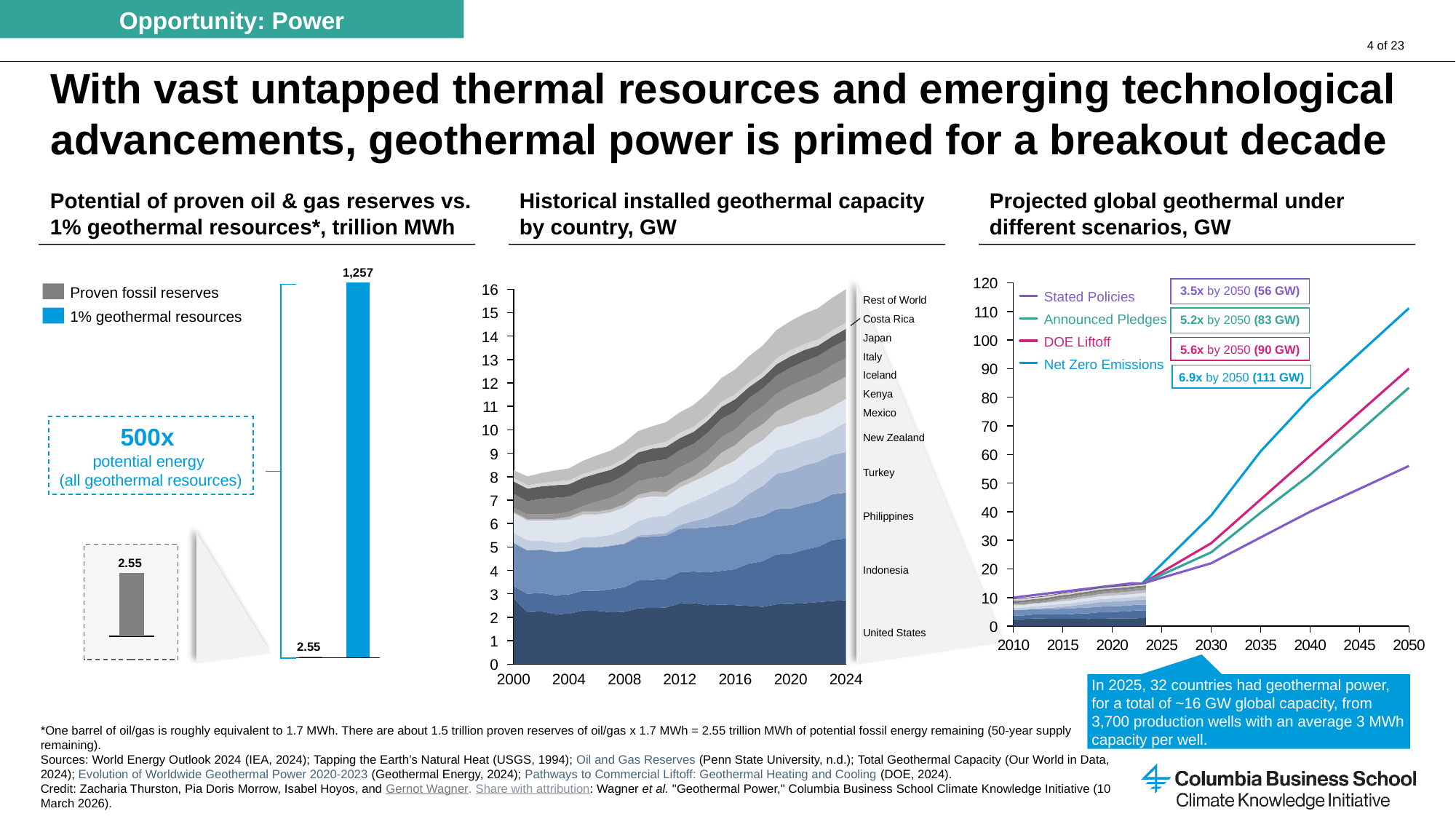
In the left chart (Potential of proven oil & gas reserves vs. 1% geothermal resources), what is the value for 1% geothermal resources? 1,257 In the right chart (Projected global geothermal under different scenarios), which scenario has the highest capacity in 2050? Net Zero Emissions In the middle chart (Historical installed geothermal capacity by country), how many countries or regions are listed as series? 12 In the middle chart (Historical installed geothermal capacity by country), is the total capacity in 2024 greater or less than 15 GW? Greater In the right chart (Projected global geothermal under different scenarios), what capacity does the Stated Policies scenario reach by 2050? 56 GW In the middle chart (Historical installed geothermal capacity by country), does total installed capacity rise or fall from 2000 to 2024? Rise In the right chart (Projected global geothermal under different scenarios), what capacity does the Net Zero Emissions scenario reach by 2050? 111 GW In the right chart (Projected global geothermal under different scenarios), how many scenarios does the legend list? 4 In the right chart (Projected global geothermal under different scenarios), what is the difference in 2050 capacity between the Net Zero Emissions and Stated Policies scenarios? 55 GW What kind of chart is the left chart comparing proven fossil reserves and 1% geothermal resources? Bar chart In the left chart (Potential of proven oil & gas reserves vs. 1% geothermal resources), what is the value for proven fossil reserves? 2.55 In the right chart (Projected global geothermal under different scenarios), what growth multiple by 2050 is shown for the DOE Liftoff scenario? 5.6x